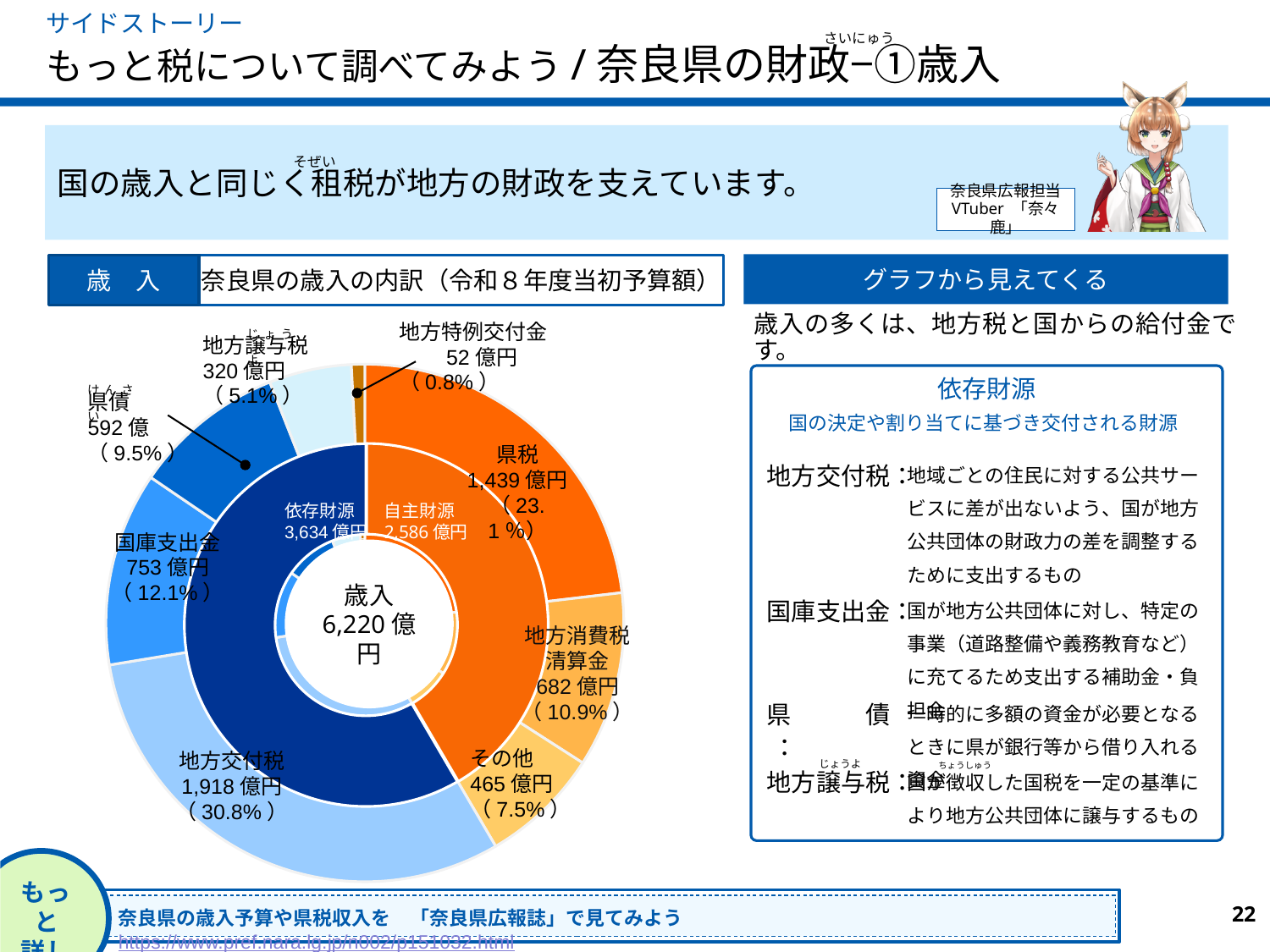
What is the total revenue (歳入) shown in the centre of the chart? 6,220 億円 What is the value shown for 依存財源 in the inner ring? 3,634 億円 What is the value shown for 国庫支出金? 753 億円 Which category in the outer ring of the revenue chart is the largest? 地方交付税 Which is larger, 地方消費税清算金 or 県債? 地方消費税清算金 How many categories are shown in the outer ring of the revenue chart? 8 What is the difference in 億円 between 地方交付税 (1,918 億円) and 県税 (1,439 億円)? 479 億円 What percentage share does 地方譲与税 have in the revenue chart? 5.1% Which category in the outer ring of the revenue chart is the smallest? 地方特例交付金 What is the value shown for 地方交付税 in the revenue chart? 1,918 億円 What percentage share does 県税 have in the revenue chart? 23.1% What kind of chart is used to show the breakdown of Nara Prefecture's revenue (奈良県の歳入の内訳)? Doughnut (pie) chart